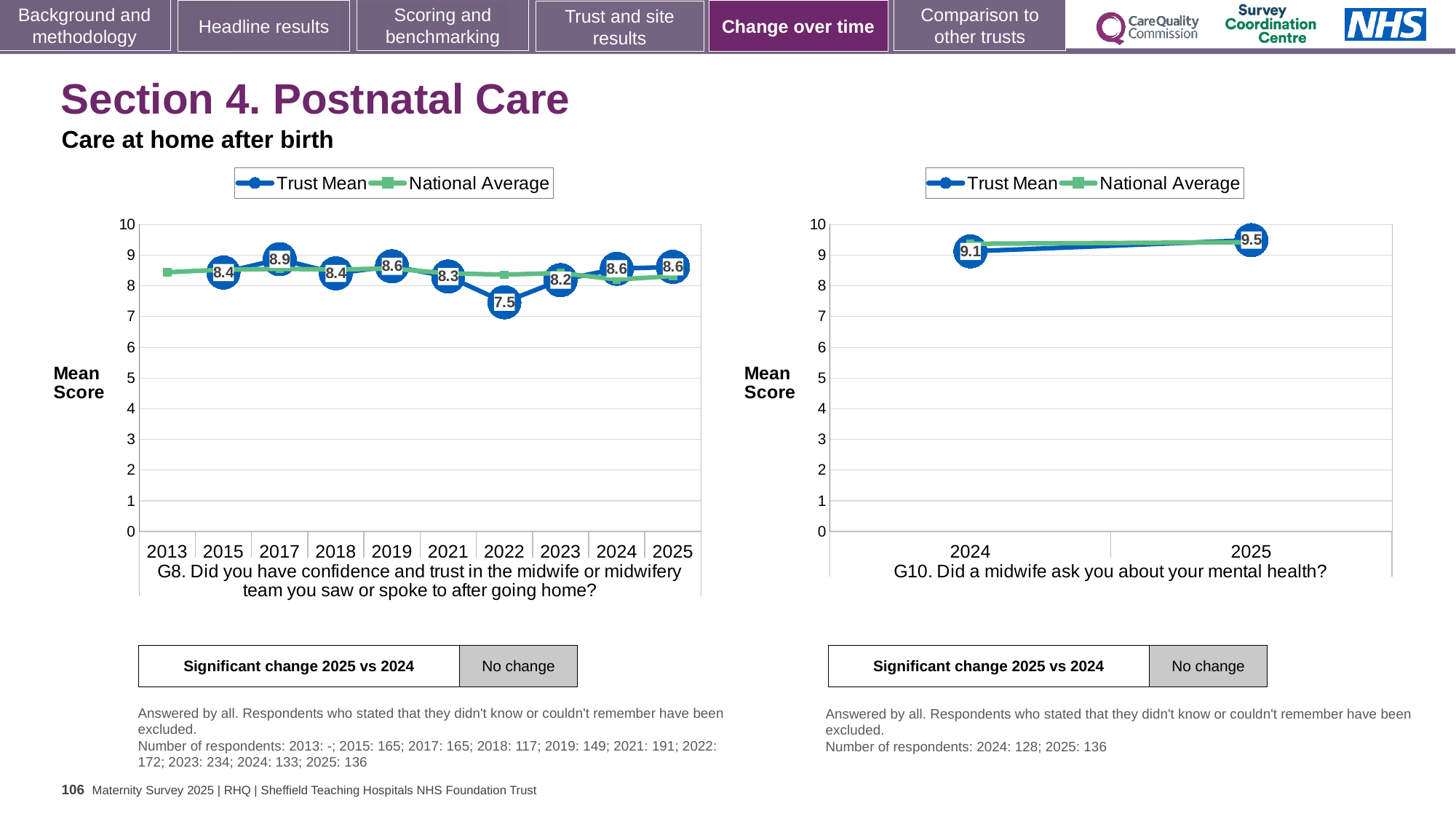
In the left chart (G8), how many years are shown on the x axis? 10 In the left chart (G8), what is the difference between the Trust Mean in 2017 and in 2022? 1.4 In the right chart (G10), what is the Trust Mean for 2025? 9.5 In the right chart (G10), does the Trust Mean rise or fall from 2024 to 2025? rise In the right chart (G10), by how much did the Trust Mean change from 2024 to 2025? 0.4 What are the two series named in the legend of the right chart (G10)? Trust Mean and National Average In the left chart (G8), is the Trust Mean higher in 2019 or in 2021? 2019 What kind of chart is the right chart (G10)? line chart In the left chart (G8), which year has the highest Trust Mean? 2017 In the left chart (G8), what is the Trust Mean for 2022? 7.5 In the left chart (G8), which year has the lowest Trust Mean? 2022 How many series does the legend of the left chart (G8) list? 2